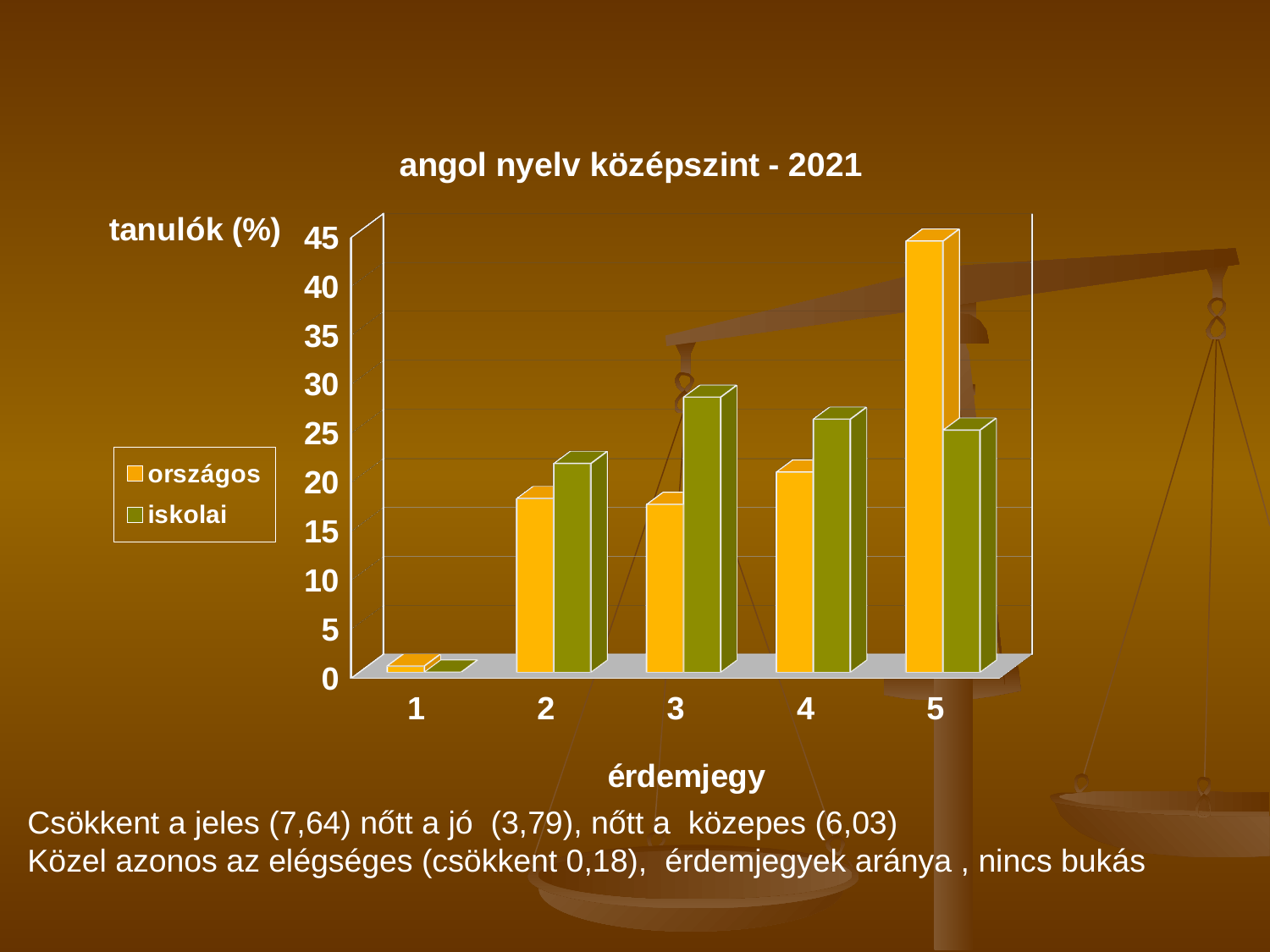
Which érdemjegy has the lowest iskolai value? 1 Is the iskolai value for érdemjegy 1 greater or less than 5? less For érdemjegy 5, which series has the larger value, országos or iskolai? országos Which érdemjegy has the highest országos value? 5 For érdemjegy 3, which series has the larger value, országos or iskolai? iskolai How many series does the legend list? 2 Is the országos value for érdemjegy 3 greater or less than 20? less What is the title of the chart? angol nyelv középszint - 2021 How many categories (érdemjegy values) are shown on the x axis? 5 What kind of chart is shown on the slide? bar chart Is the iskolai value for érdemjegy 3 greater or less than 25? greater